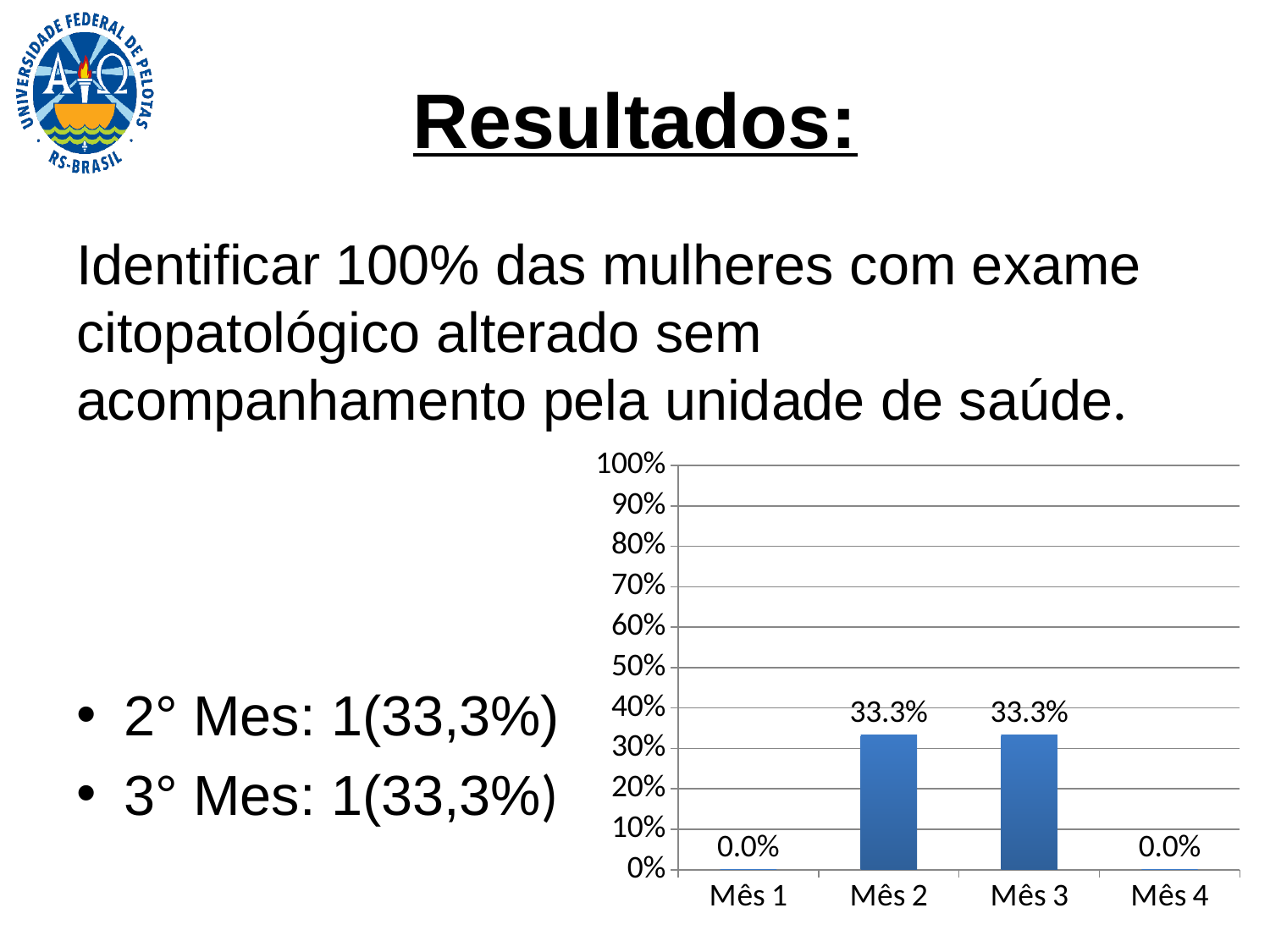
How many categories are shown on the x axis? 4 Which is larger, the value for Mês 2 or the value for Mês 4? Mês 2 Which months have a value of 0.0%? Mês 1 and Mês 4 What is the value for Mês 4? 0.0% What is the value for Mês 3? 33.3% Do the values for Mês 2 and Mês 3 differ? No, both are 33.3% Is the value for Mês 2 greater or less than 50%? less What is the difference between the values for Mês 3 and Mês 1? 33.3% What is the value for Mês 2? 33.3% What is the highest value shown on the y axis? 100% What kind of chart is shown on the slide? bar chart What is the value for Mês 1? 0.0%